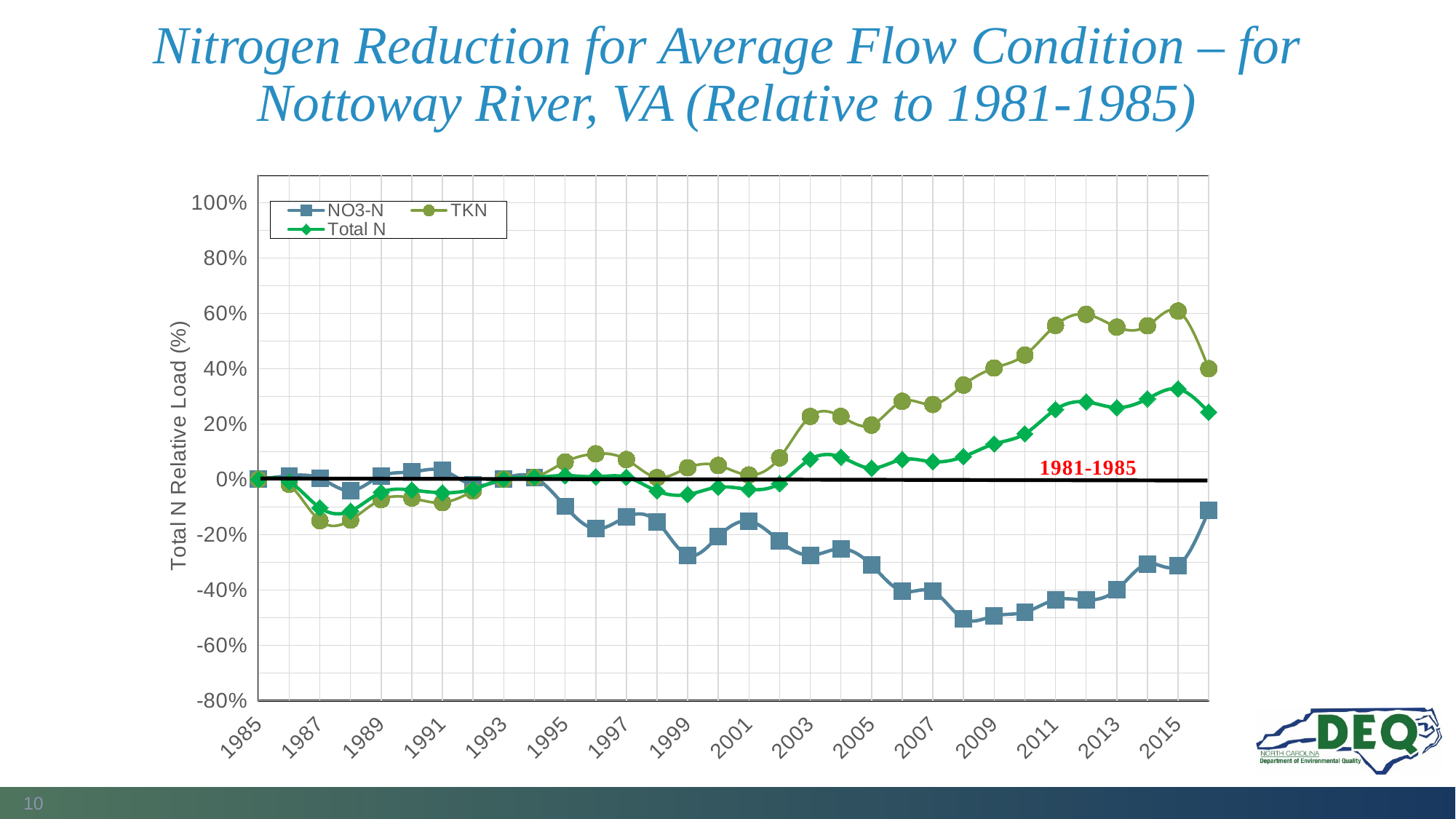
What is the label on the y axis? Total N Relative Load (%) What kind of chart is shown on the slide? line chart How many series does the legend list? 3 Which series are listed in the legend? NO3-N, TKN, Total N Is the Total N value for 2015 greater or less than 20%? greater In 2009, which series has the larger value, NO3-N or Total N? Total N Is the TKN value for 2003 greater or less than 0%? greater Does the TKN series generally rise or fall between 2001 and 2015? rise Is the NO3-N value for 2009 greater or less than -40%? less Which series reaches the lowest value on the chart? NO3-N In 2015, which series has the larger value, TKN or Total N? TKN